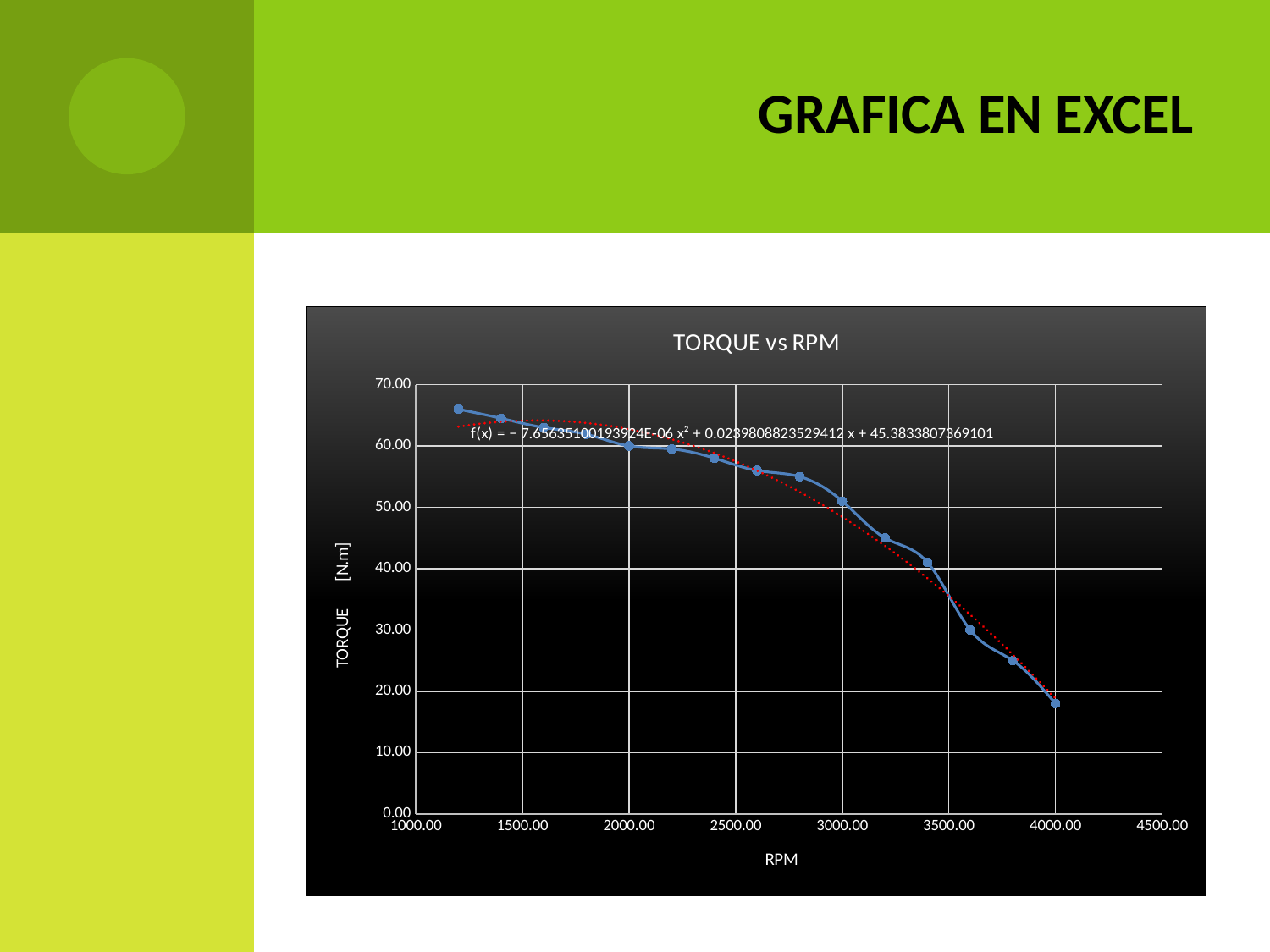
What kind of chart is shown on the slide? line chart Which has the larger torque, 2000 RPM or 3000 RPM? 2000 RPM Is the torque at 1200 RPM greater or less than 60.00? greater Is the torque at 4000 RPM greater or less than 30.00? less Is the torque at 3800 RPM greater or less than 30.00? less What is the title of the chart? TORQUE vs RPM What is the label of the horizontal axis of the chart? RPM At which RPM value is the torque lowest? 4000.00 Does the torque rise or fall as RPM increases along the x axis? fall Which has the larger torque, 1200 RPM or 4000 RPM? 1200 RPM